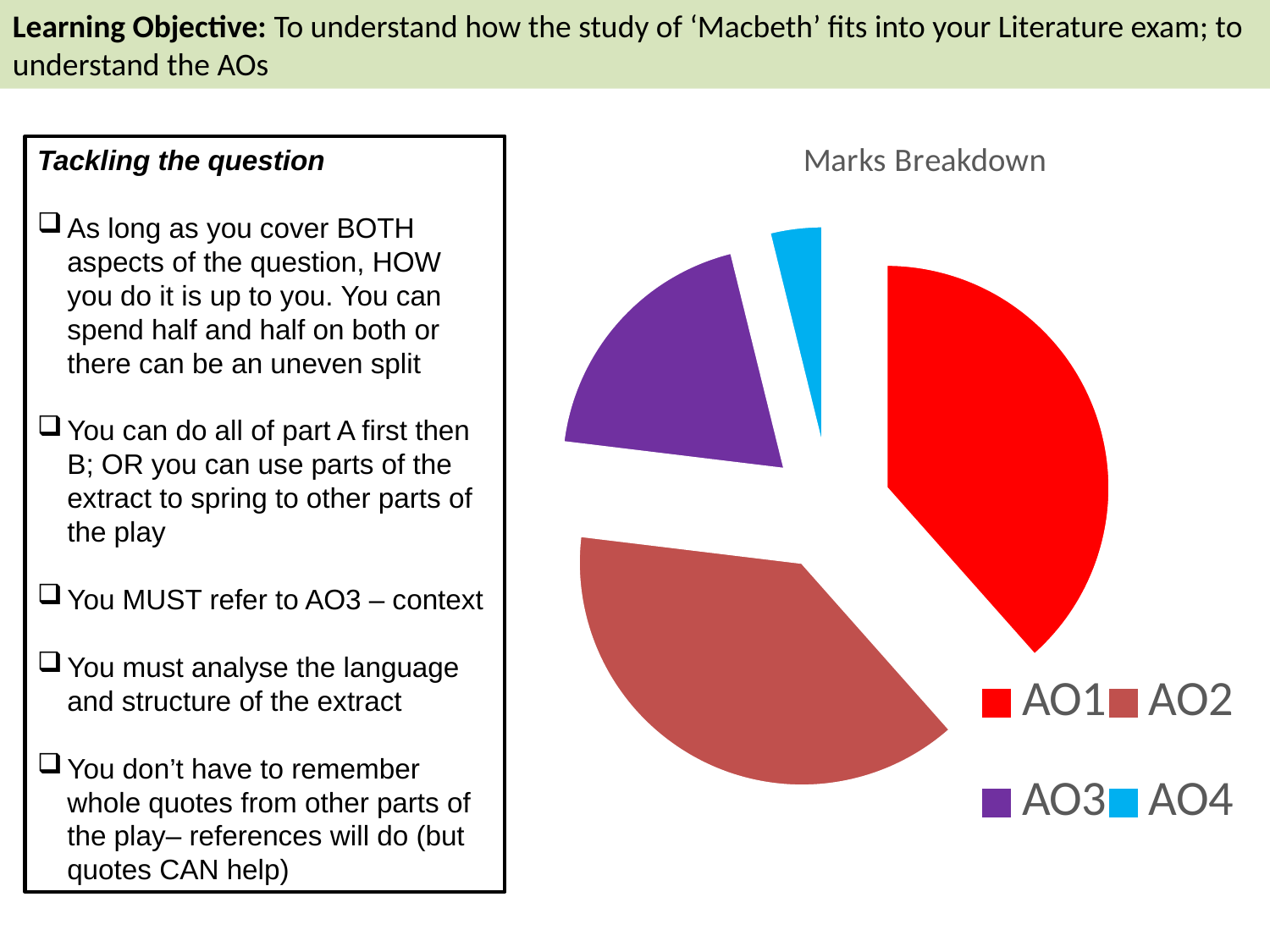
Which category has the smallest slice of the pie? AO4 Which categories are listed in the chart's legend? AO1, AO2, AO3, AO4 Which slice is larger, AO2 or AO4? AO2 What kind of chart is shown on the slide? pie chart Which slice is larger, AO3 or AO4? AO3 How many slices does the pie chart have? 4 Which slice is larger, AO2 or AO3? AO2 What colour is the AO1 slice in the pie chart? red What is the title of the chart? Marks Breakdown